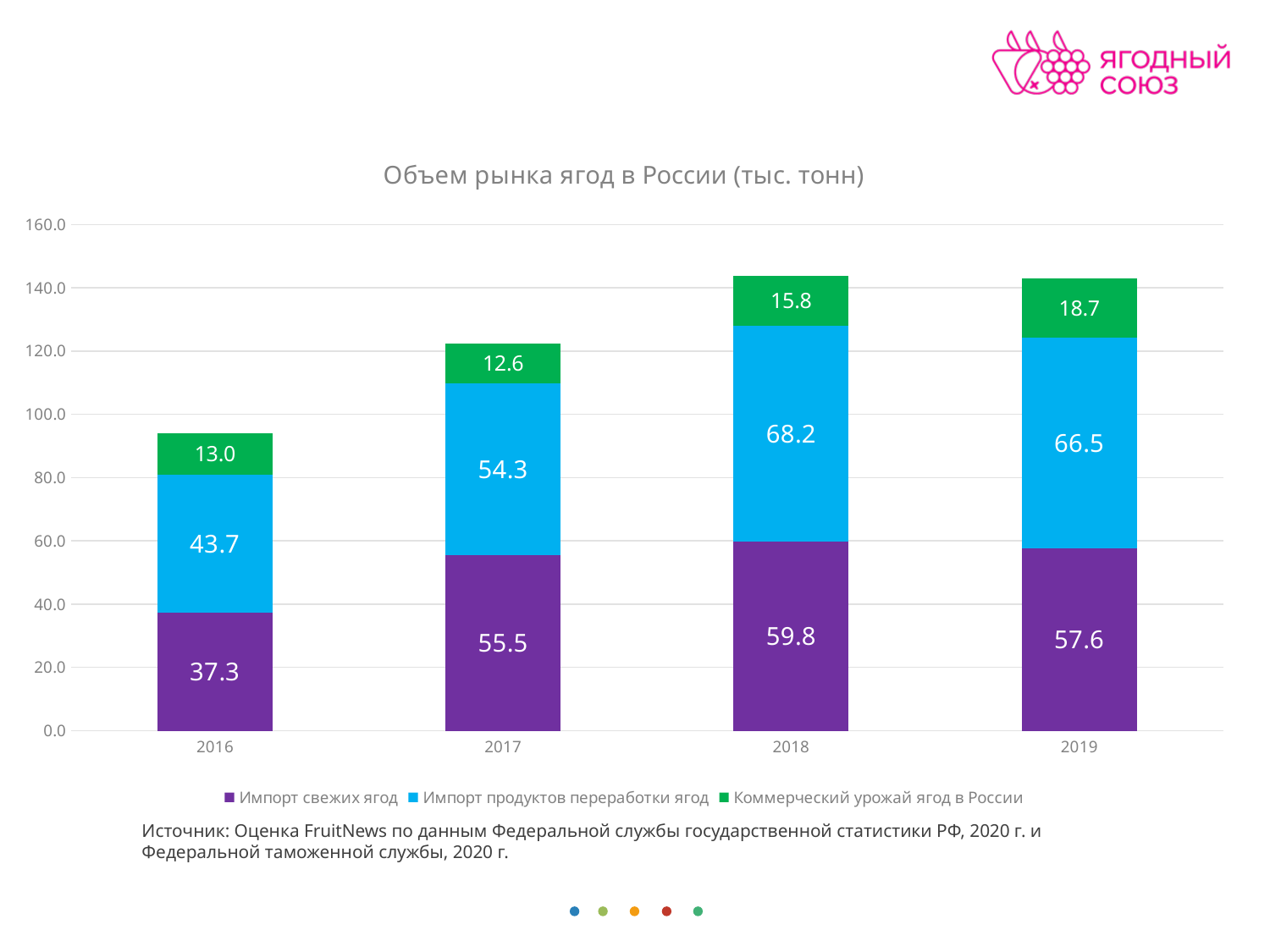
What kind of chart is shown on the slide? Stacked bar chart What is the value for Импорт продуктов переработки ягод in 2018? 68.2 Is the total height of the 2016 bar greater or less than 100.0? less What is the value for Коммерческий урожай ягод в России in 2019? 18.7 What is the difference between Импорт продуктов переработки ягод in 2018 and in 2017? 13.9 In which year is Импорт свежих ягод the lowest? 2016 What is the total of the stacked bar for 2018? 143.8 How many years are shown on the x axis? 4 How many series does the legend list? 3 What is the value for Импорт свежих ягод in 2016? 37.3 Which is larger in 2019: Импорт свежих ягод or Импорт продуктов переработки ягод? Импорт продуктов переработки ягод In which year is Коммерческий урожай ягод в России the highest? 2019